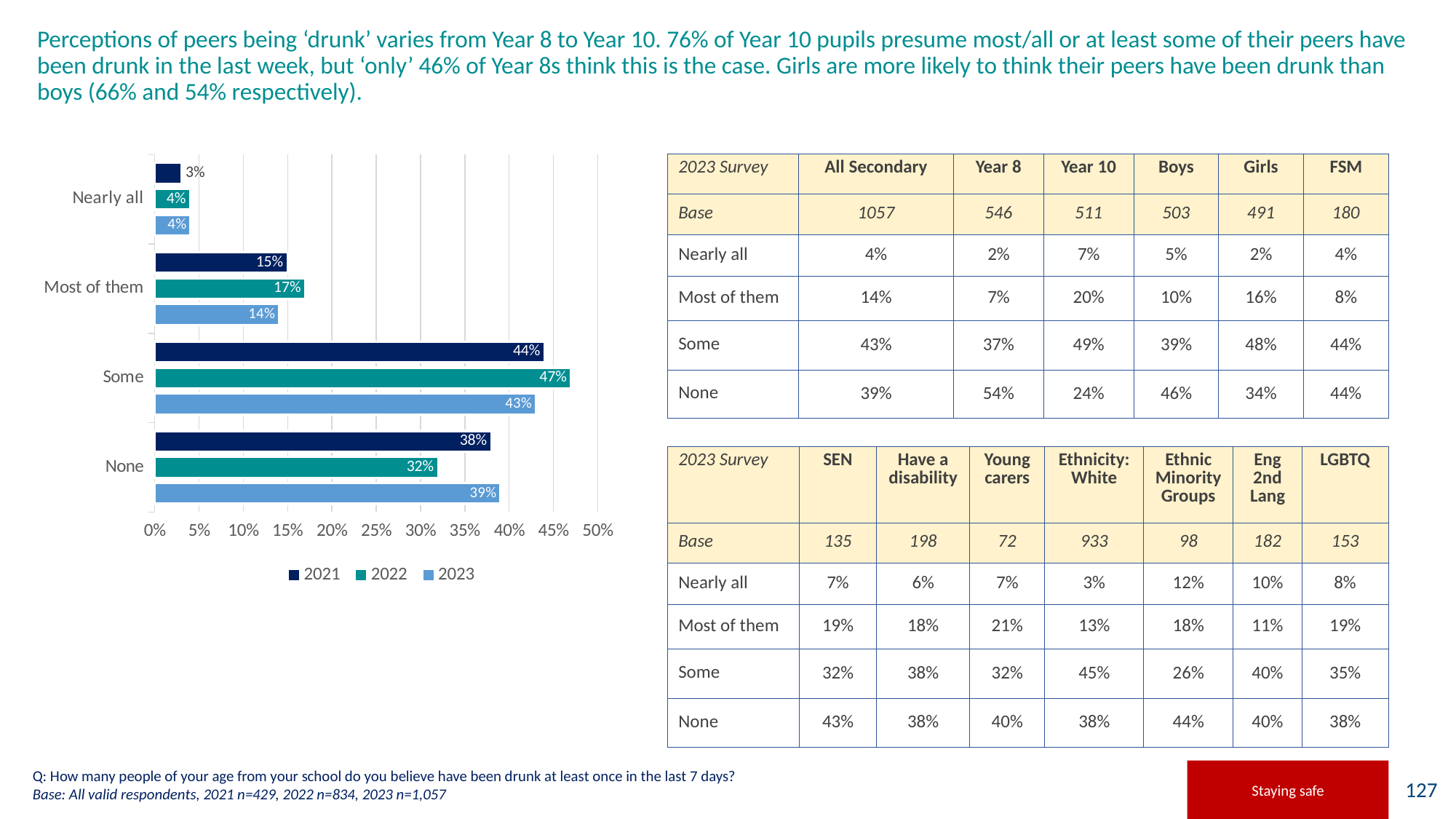
What kind of chart is shown on the slide? bar chart What is the 2023 value for 'None'? 39% What is the difference between the 2021 and 2022 values for 'None'? 6% What is the 2021 value for 'Most of them'? 15% How many series does the chart legend list? 3 Which category has the lowest 2023 value? Nearly all What is the 2022 value for 'Some'? 47% Which category has the highest 2021 value? Some Is the 2023 value for 'Some' greater or less than 40%? greater Which series is shown in the darkest blue colour in the chart? 2021 Which is larger for 'Most of them': the 2022 value or the 2023 value? 2022 How many categories are shown on the chart? 4